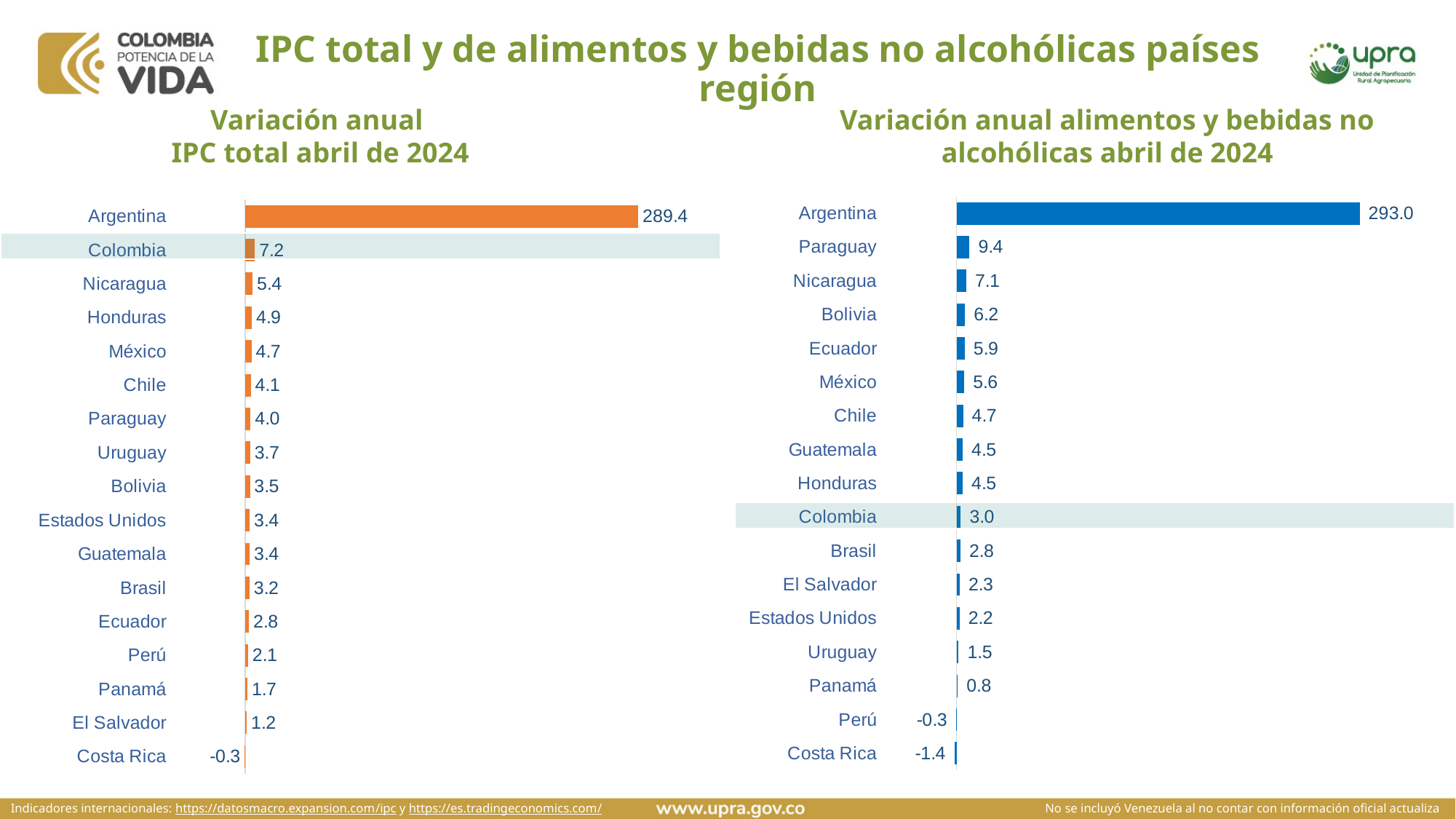
In the 'Variación anual alimentos y bebidas no alcohólicas abril de 2024' chart, which is larger, the value for Bolivia or the value for Ecuador? Bolivia In the 'Variación anual IPC total abril de 2024' chart, what is the difference between the values for Nicaragua and Honduras? 0.5 In the 'Variación anual IPC total abril de 2024' chart, which country has the highest value? Argentina What kind of chart is the 'Variación anual IPC total abril de 2024' chart? Bar chart In the 'Variación anual IPC total abril de 2024' chart, what is the value for Costa Rica? -0.3 In the 'Variación anual alimentos y bebidas no alcohólicas abril de 2024' chart, which country has the lowest value? Costa Rica How many countries are shown in the 'Variación anual alimentos y bebidas no alcohólicas abril de 2024' chart? 17 How many countries are shown in the 'Variación anual IPC total abril de 2024' chart? 17 In the 'Variación anual IPC total abril de 2024' chart, what is the value for Colombia? 7.2 In the 'Variación anual alimentos y bebidas no alcohólicas abril de 2024' chart, what is the value for Paraguay? 9.4 What colour are the bars in the 'Variación anual IPC total abril de 2024' chart? Orange In the 'Variación anual alimentos y bebidas no alcohólicas abril de 2024' chart, what is the value for Colombia? 3.0